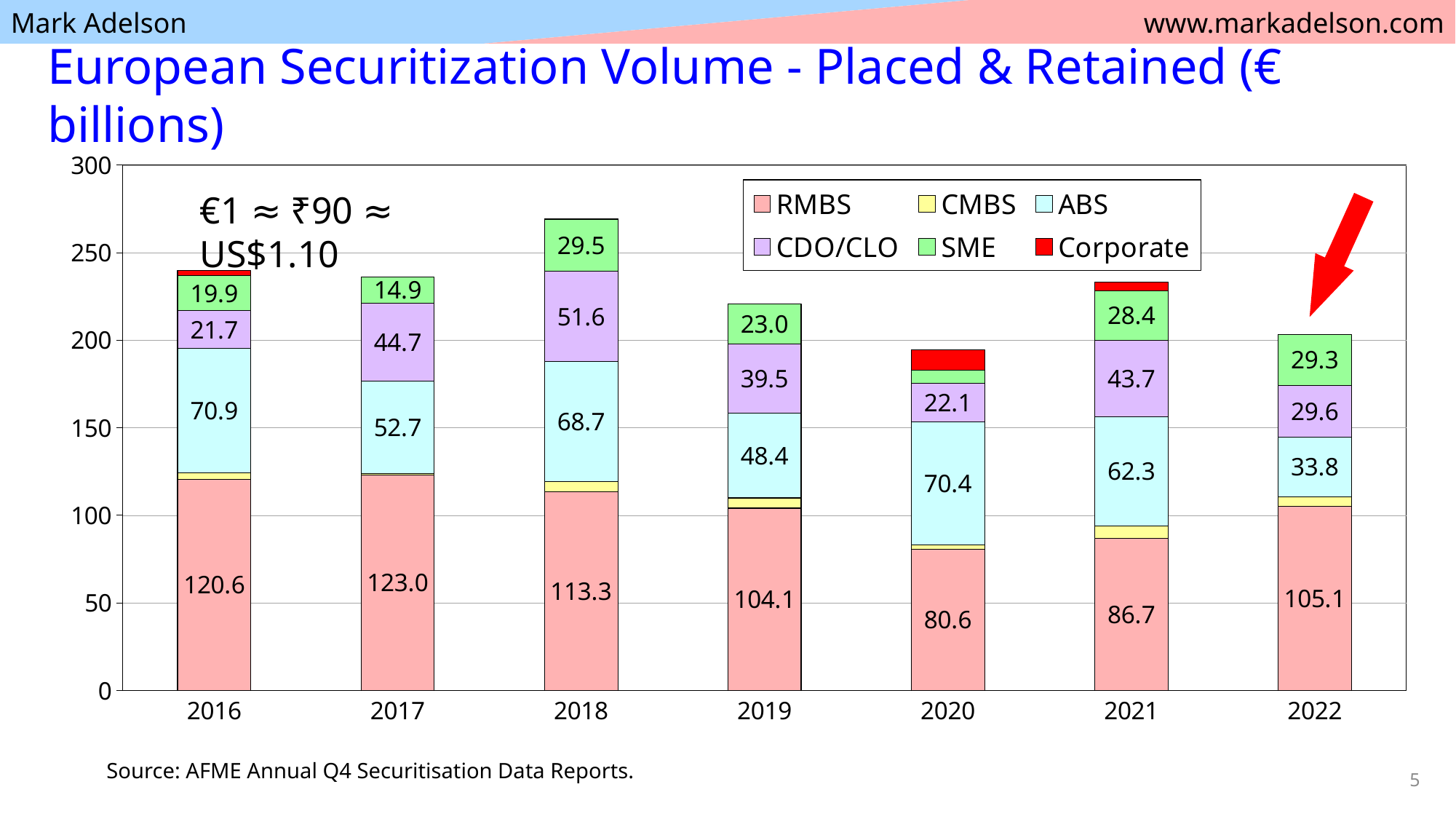
In which year is the RMBS value lowest? 2020 In 2019, which is larger: the ABS value or the CDO/CLO value? ABS Is the total height of the 2018 stacked bar greater or less than 250? greater What is the difference between the RMBS value in 2017 and in 2020? 42.4 What is the CDO/CLO value for 2018? 51.6 What is the ABS value for 2016? 70.9 How many series does the legend list? 6 What is the SME value for 2022? 29.3 What is the RMBS value for 2017? 123.0 What kind of chart is shown on the slide? Stacked bar chart In which year is the RMBS value highest? 2017 How many years are shown on the x axis? 7